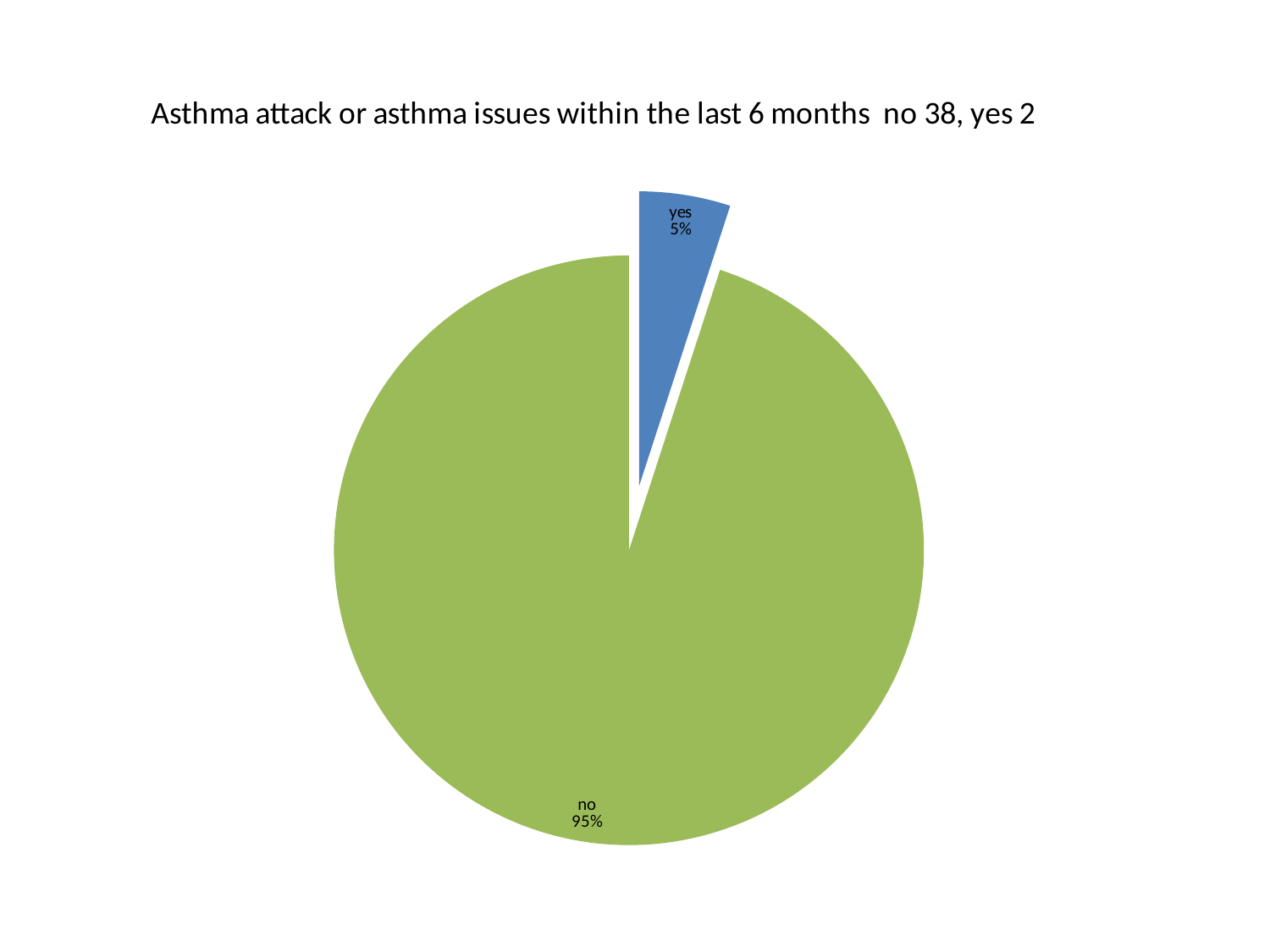
What kind of chart is shown on the slide? pie chart What is the title of the chart? Asthma attack or asthma issues within the last 6 months no 38, yes 2 Which slice is the smallest? yes Which slice is the largest? no What colour is the "yes" slice? blue According to the chart title, how many respondents answered "no"? 38 What percentage share does the "yes" slice have? 5% Which slice is larger, "yes" or "no"? no What is the difference in percentage points between the "no" and "yes" slices? 90 How many slices does the pie chart have? 2 What percentage share does the "no" slice have? 95% According to the chart title, how many respondents answered "yes"? 2